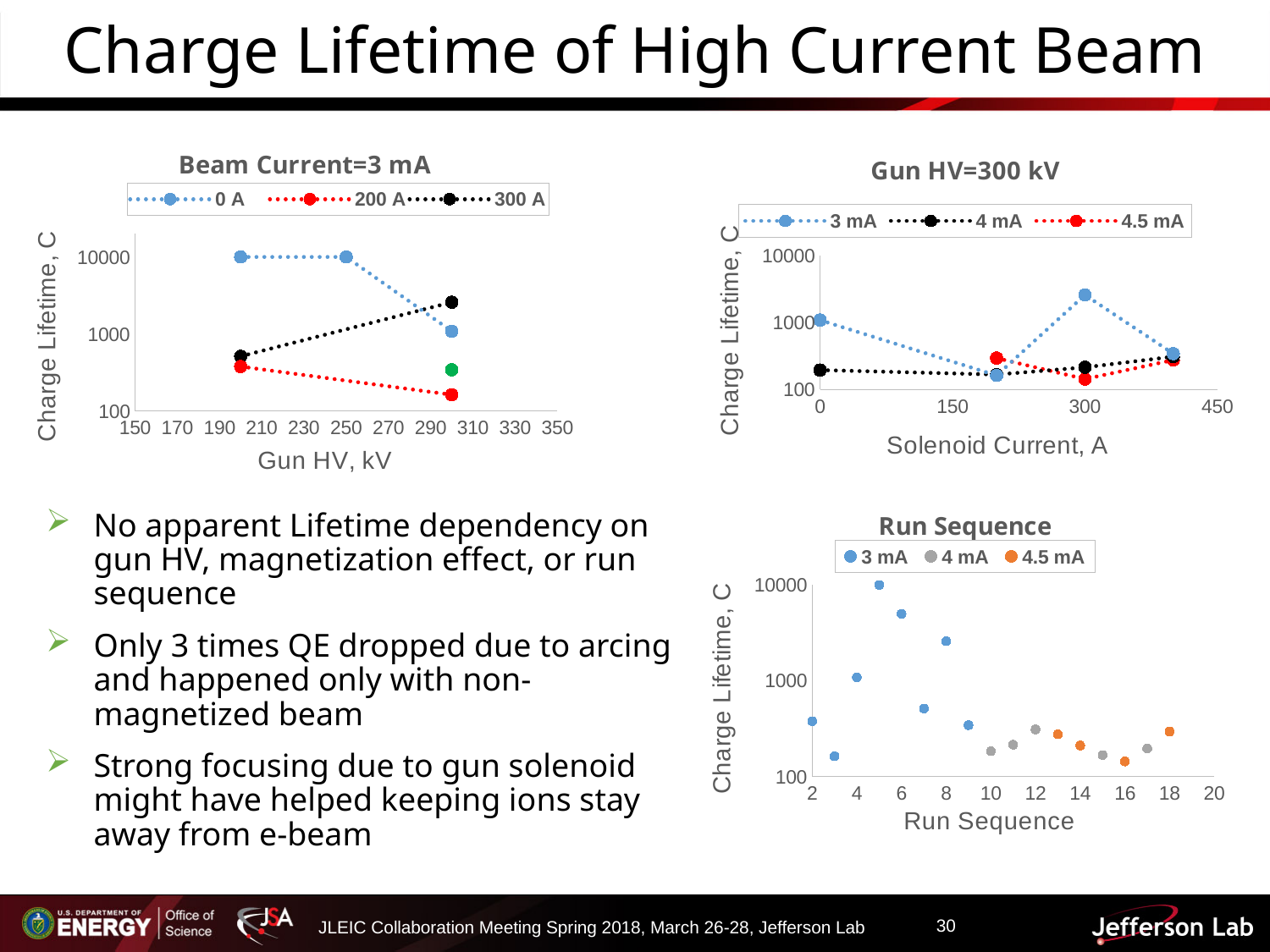
What are the legend entries of the "Gun HV=300 kV" chart? 3 mA, 4 mA, 4.5 mA In the "Gun HV=300 kV" chart, is the value of the 3 mA series at 300 A greater or less than 1000? greater How many series does the legend of the "Beam Current=3 mA" chart list? 3 What kind of chart is the "Beam Current=3 mA" chart? Scatter chart In the "Beam Current=3 mA" chart, is the value of the 300 A series at 300 kV greater or less than 1000? greater In the "Run Sequence" chart, which run sequence number has the highest charge lifetime? 5 In the "Gun HV=300 kV" chart, at a solenoid current of 300 A, which series has the larger charge lifetime: 3 mA or 4.5 mA? 3 mA In the "Beam Current=3 mA" chart, does the 200 A series rise or fall from 200 kV to 300 kV? Fall In the "Beam Current=3 mA" chart, is the value of the 200 A series at 300 kV greater or less than 1000? less What is the x-axis title of the "Gun HV=300 kV" chart? Solenoid Current, A In the "Beam Current=3 mA" chart, at 300 kV, which series has the larger charge lifetime: 200 A or 300 A? 300 A How many data points does the 0 A series have in the "Beam Current=3 mA" chart? 3